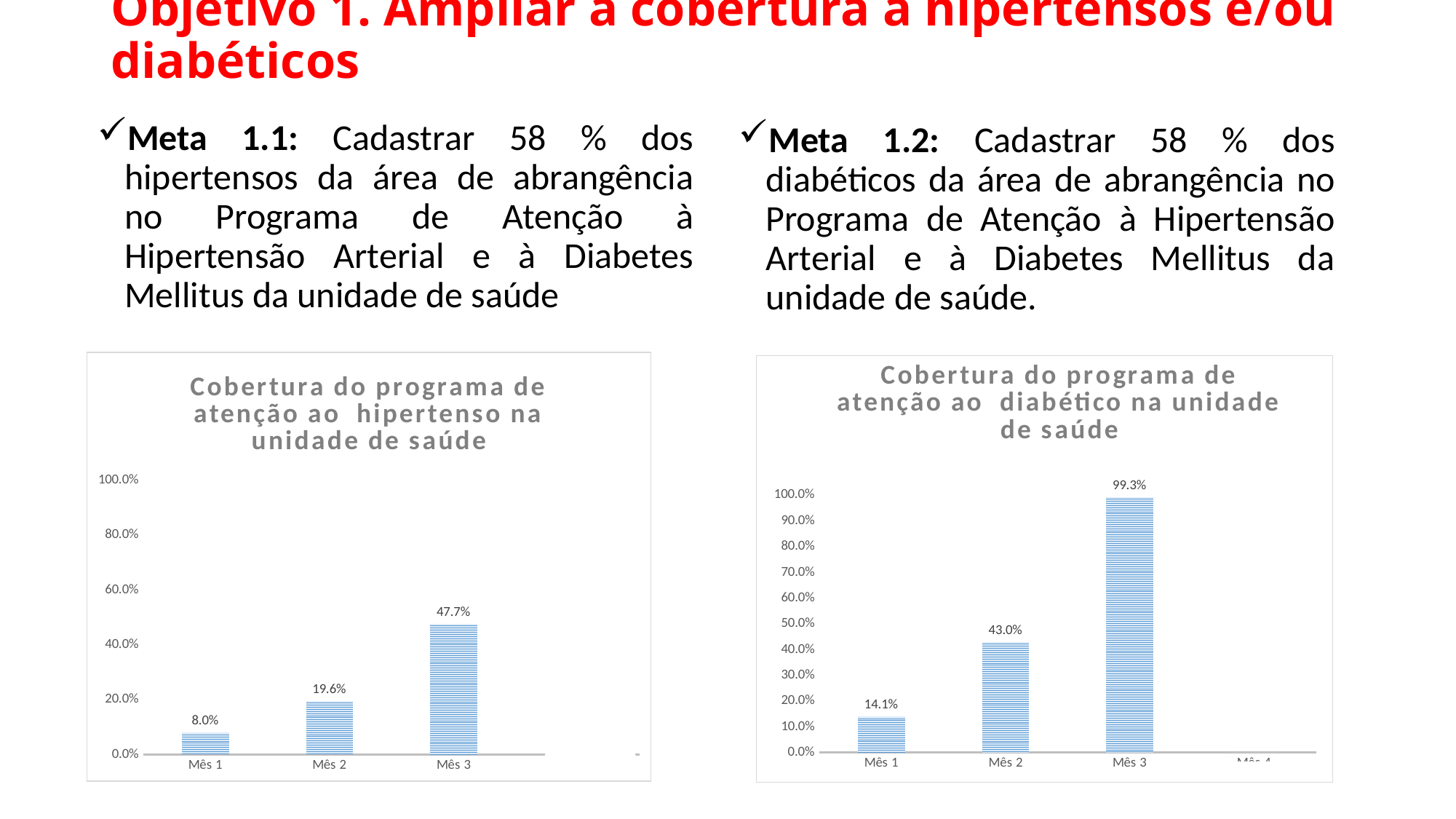
In the chart 'Cobertura do programa de atenção ao diabético na unidade de saúde', what is the value for Mês 3? 99.3% In the chart 'Cobertura do programa de atenção ao hipertenso na unidade de saúde', what is the value for Mês 1? 8.0% What kind of chart is the chart on the right of the slide, 'Cobertura do programa de atenção ao diabético na unidade de saúde'? bar chart In the chart 'Cobertura do programa de atenção ao hipertenso na unidade de saúde', is the value for Mês 3 greater or less than 60%? less Which is larger: the Mês 2 value in the hipertenso chart (left) or the Mês 2 value in the diabético chart (right)? The diabético chart (43.0%) In the chart 'Cobertura do programa de atenção ao hipertenso na unidade de saúde', what is the difference between the values for Mês 3 and Mês 1? 39.7 percentage points In the chart 'Cobertura do programa de atenção ao hipertenso na unidade de saúde', do the values rise or fall from Mês 1 to Mês 3? rise In the chart 'Cobertura do programa de atenção ao diabético na unidade de saúde', what is the difference between the values for Mês 3 and Mês 2? 56.3 percentage points In the chart 'Cobertura do programa de atenção ao diabético na unidade de saúde', what is the value for Mês 1? 14.1% In the chart 'Cobertura do programa de atenção ao hipertenso na unidade de saúde', what is the value for Mês 2? 19.6% In the chart 'Cobertura do programa de atenção ao hipertenso na unidade de saúde', which month has the highest value? Mês 3